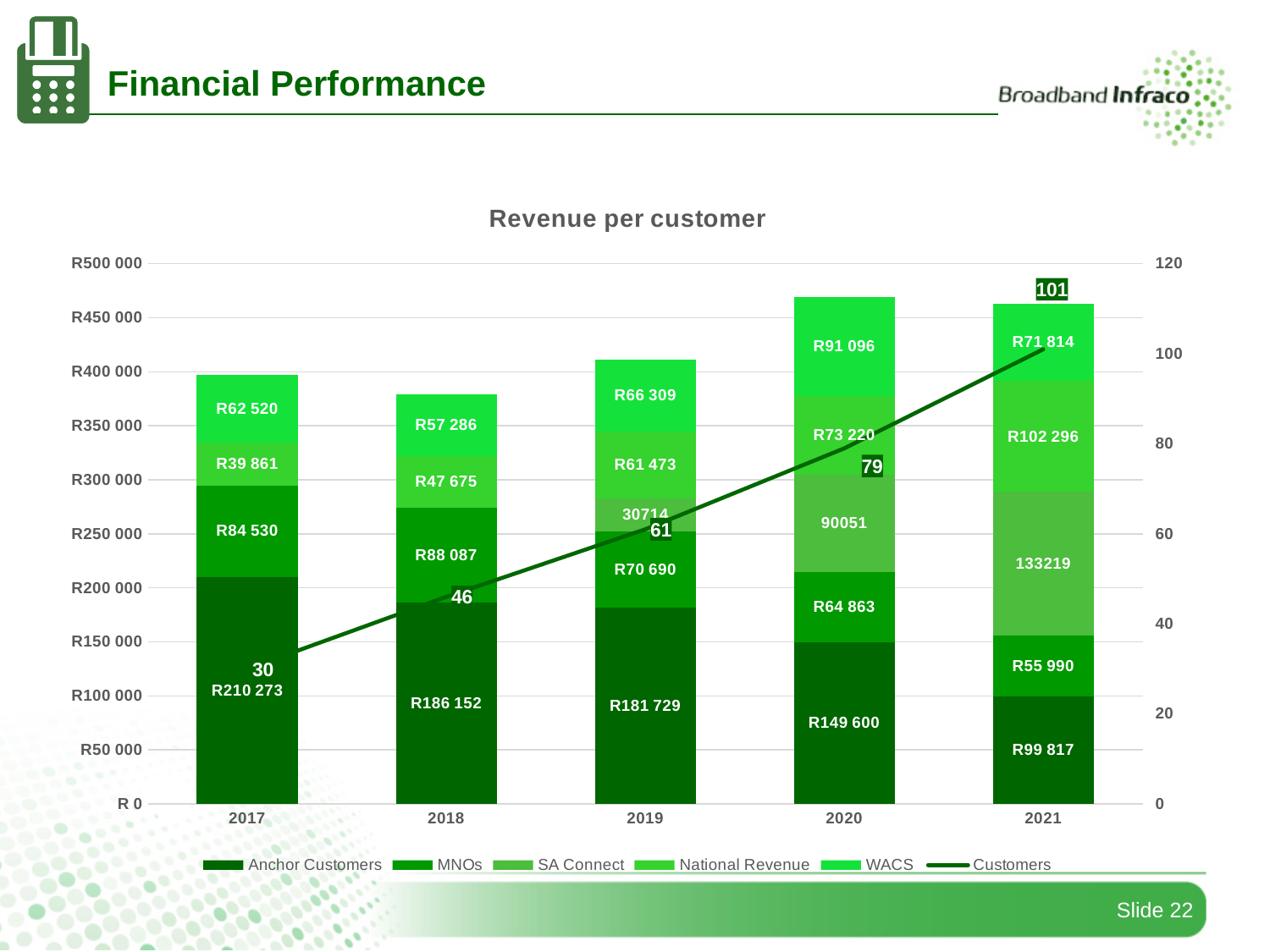
What is the Anchor Customers value for 2017? R210 273 How many years are shown on the x axis? 5 In which year is the Anchor Customers value highest? 2017 What is the WACS value for 2019? R66 309 By how much did the Customers value increase from 2017 to 2021? 71 Which year has the larger WACS value, 2020 or 2021? 2020 What is the SA Connect value for 2020? 90051 What kind of chart is shown on the slide? Stacked bar chart with a line Does the Customers line rise or fall from 2017 to 2021? Rises How many series does the legend list? 6 In which year is the Anchor Customers value lowest? 2021 What is the Customers value for 2021? 101